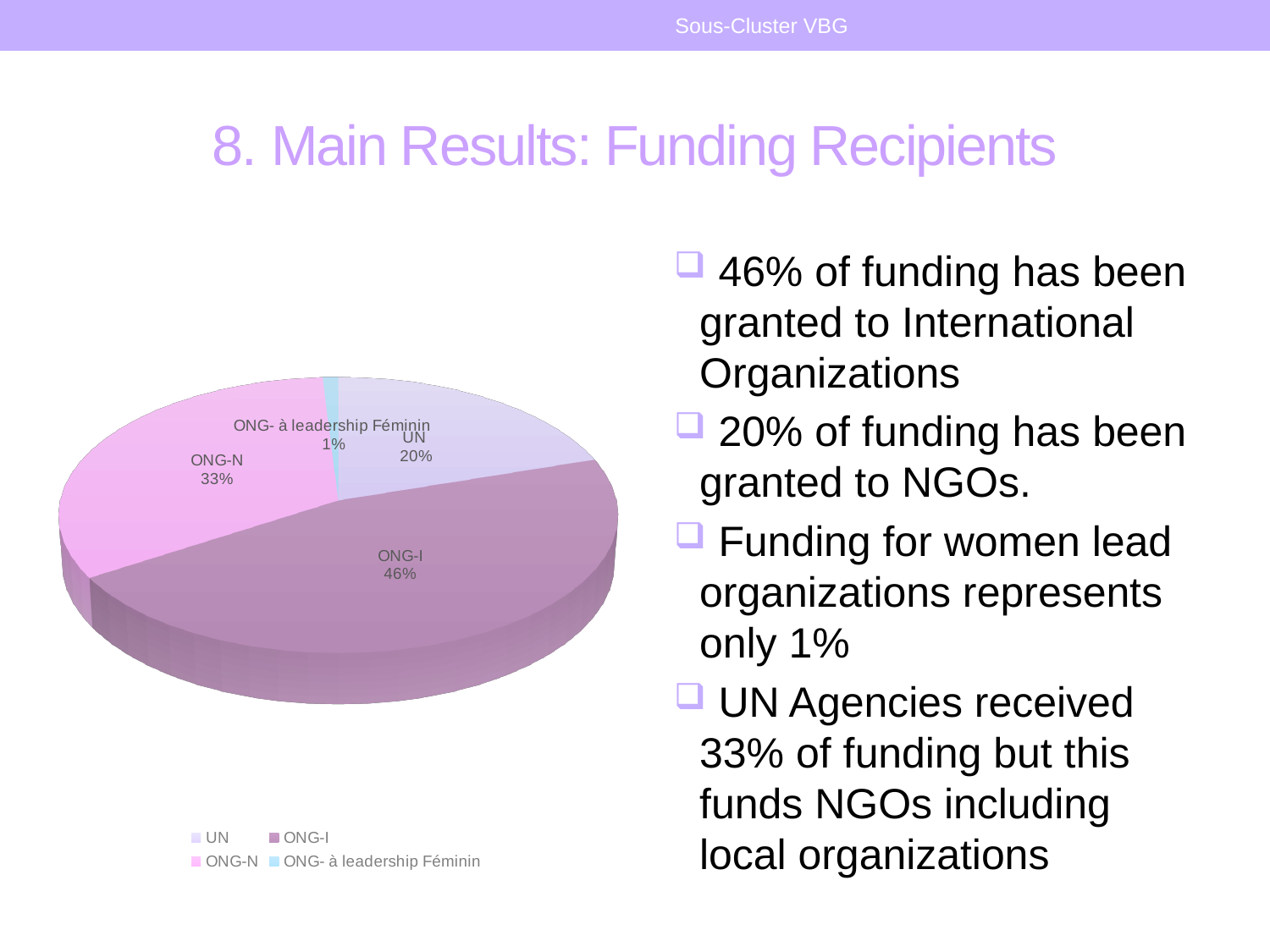
Which category has the largest slice of the pie? ONG-I What type of chart is shown on the slide? Pie chart What percentage is shown for the UN slice? 20% Which category has the smallest slice of the pie? ONG- à leadership Féminin How many entries does the legend list? 4 What percentage of funding does the ONG-I slice represent? 46% What percentage is shown for the ONG-N slice? 33% What is the difference in percentage points between the ONG-I slice and the ONG-N slice? 13 What is the combined share of the UN and ONG-N slices? 53% How many slices does the pie chart have? 4 What percentage is shown for the ONG- à leadership Féminin slice? 1% Which slice is larger, UN or ONG-N? ONG-N